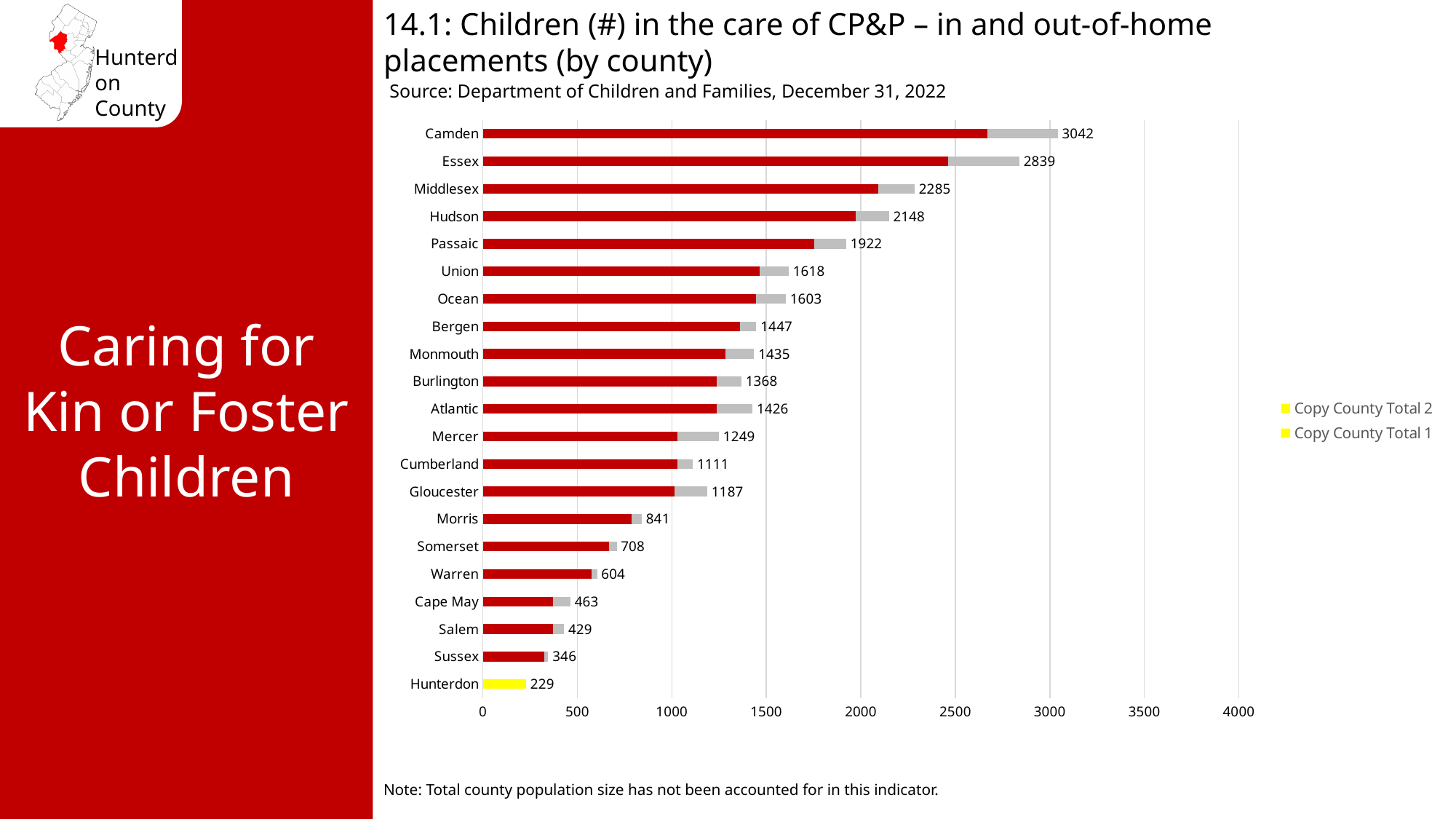
Which county has the lowest total number of children in care? Hunterdon What is the difference between the totals for Atlantic and Burlington? 58 Which county has the highest total number of children in care? Camden What is the total number of children in the care of CP&P for Camden? 3042 How many series does the legend list? 2 How many counties are shown in the chart? 21 What is the total value shown for Hunterdon? 229 What kind of chart is shown on the slide? bar chart Is the total for Hudson greater or less than 2000? greater Which has a larger total, Gloucester or Cumberland? Gloucester What is the total value shown for Passaic? 1922 What is the difference between the totals for Camden and Essex? 203